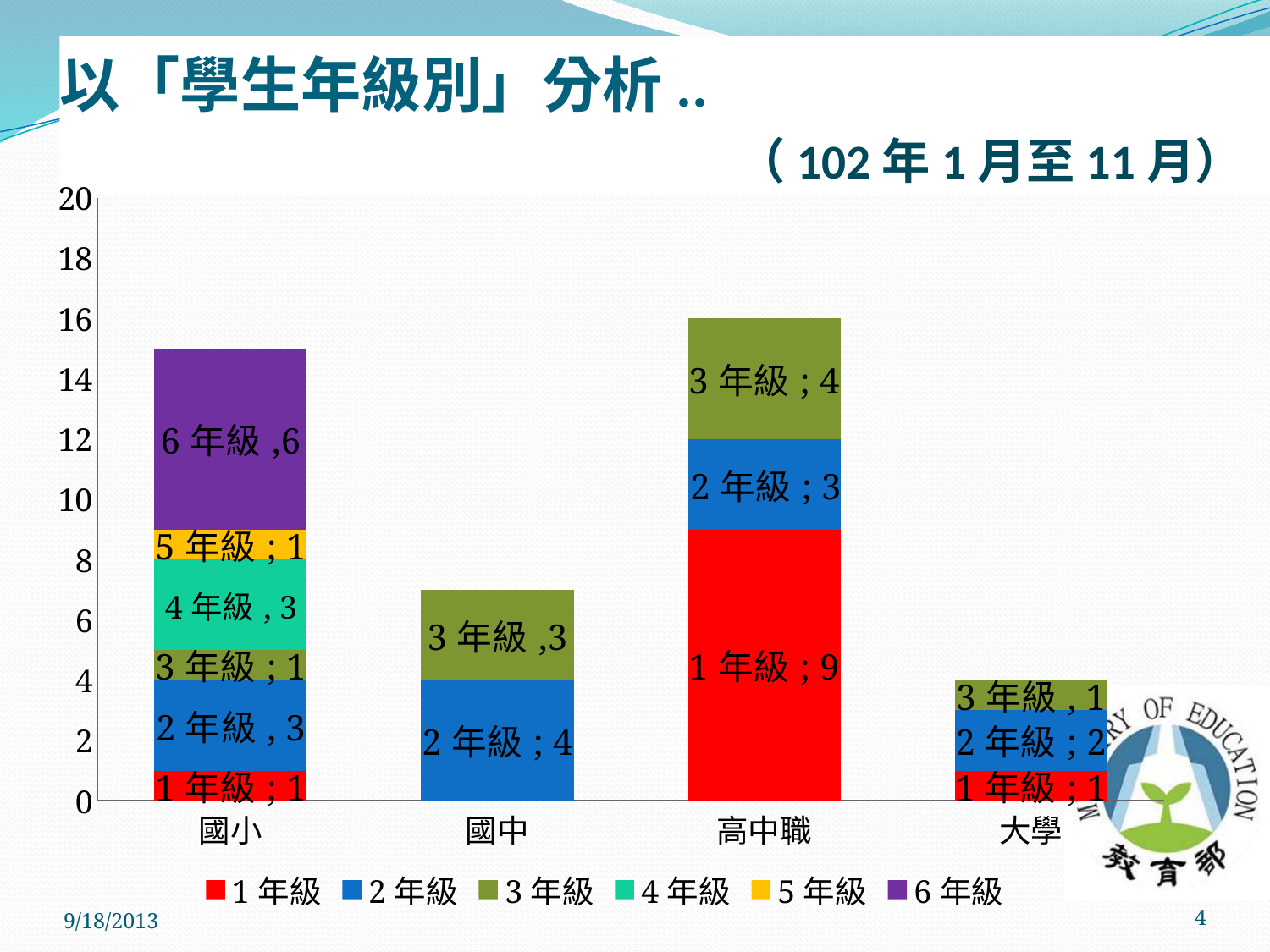
What is the total of the 高中職 stacked bar? 16 What is the difference between the 1 年級 value for 高中職 and the 1 年級 value for 國小? 8 What is the value for 3 年級 in the 大學 bar? 1 What is the value for 6 年級 in the 國小 bar? 6 What is the value for 2 年級 in the 國中 bar? 4 Which category has the lowest total? 大學 What kind of chart is shown on the slide? Stacked bar chart How many series does the legend list? 6 Which is larger: the 2 年級 value for 國中 or the 2 年級 value for 大學? 國中 What is the value for 1 年級 in the 高中職 bar? 9 What is the total of the 國小 stacked bar? 15 How many categories are shown on the x axis? 4